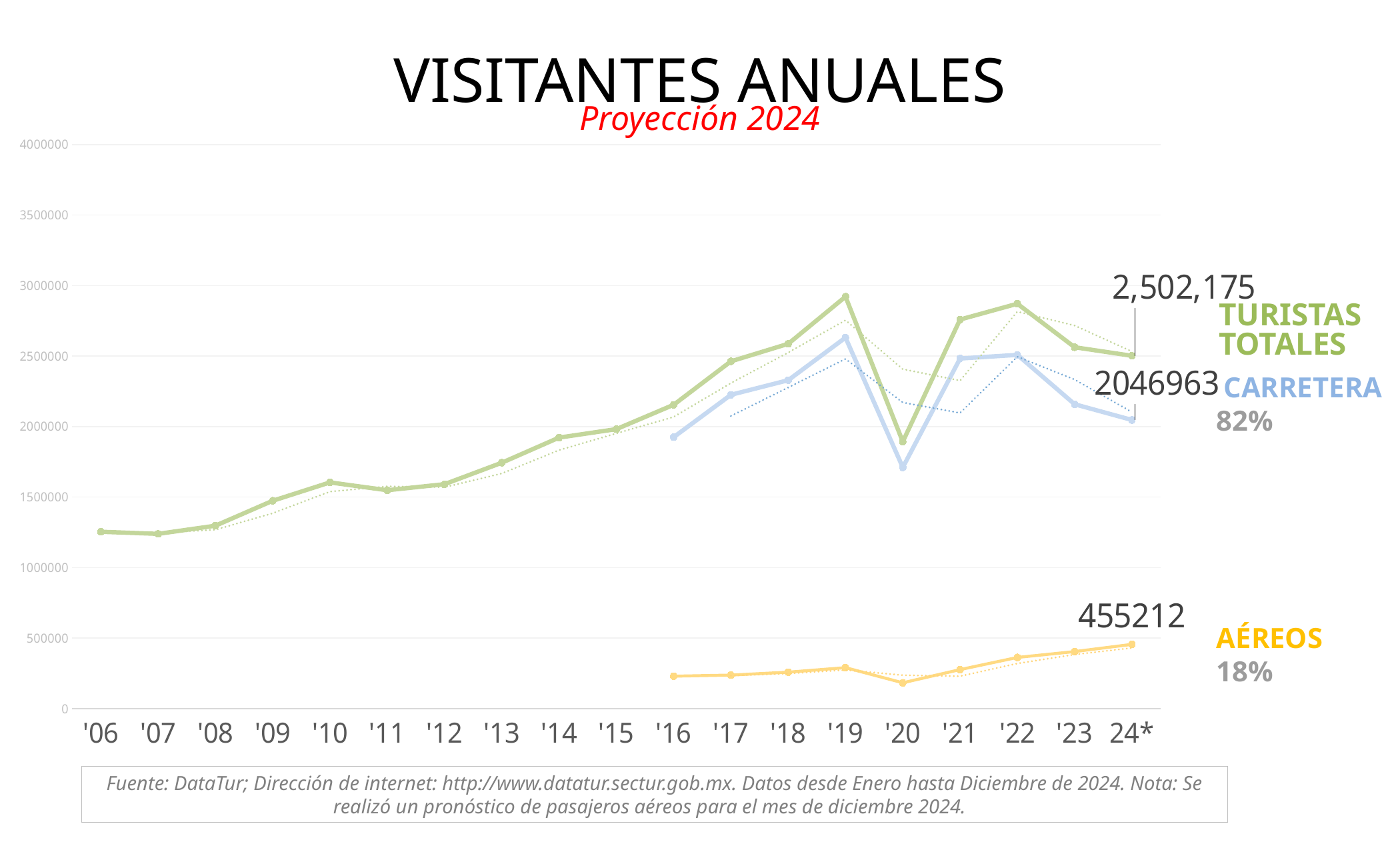
What percentage share is shown for AÉREOS? 18% Do the AÉREOS values rise or fall from '20 to 24*? Rise What is the value for AÉREOS in 24*? 455212 What is the value for CARRETERA in 24*? 2046963 How many series are labelled on the chart? 3 Is the value for CARRETERA in '20 greater or less than 2000000? less What is the value for TURISTAS TOTALES in 24*? 2,502,175 What is the difference between the CARRETERA and AÉREOS values in 24*? 1591751 How many years are shown on the x axis? 19 What percentage share is shown for CARRETERA? 82% Is the value for TURISTAS TOTALES in '19 greater or less than 2500000? greater What kind of chart is shown on the slide? Line chart